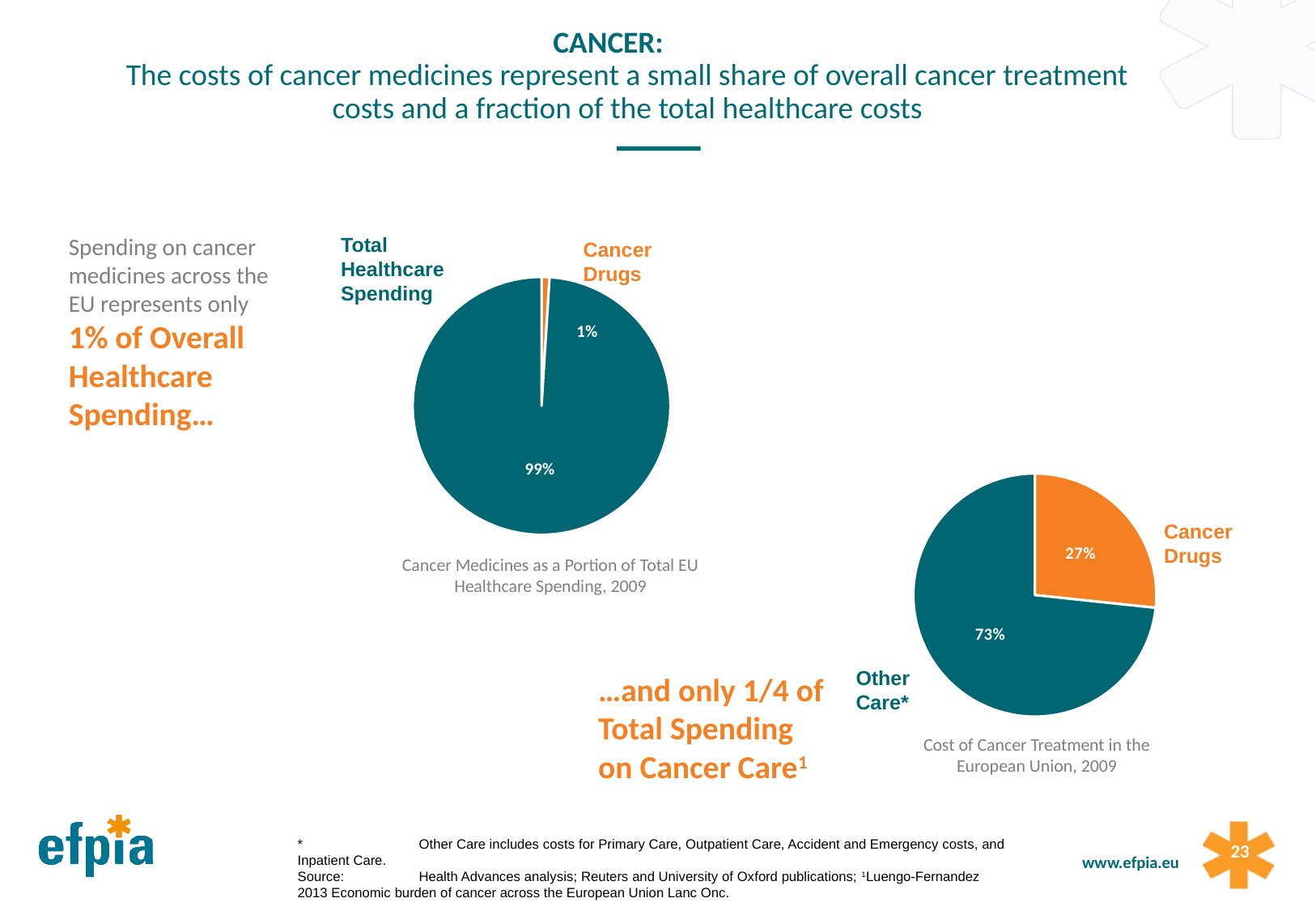
What kind of chart is the one titled 'Cost of Cancer Treatment in the European Union, 2009'? Pie chart In the chart titled 'Cancer Medicines as a Portion of Total EU Healthcare Spending, 2009', which slice is the smallest? Cancer Drugs How many slices does the chart titled 'Cancer Medicines as a Portion of Total EU Healthcare Spending, 2009' have? 2 In the chart titled 'Cost of Cancer Treatment in the European Union, 2009', which is larger, Cancer Drugs or Other Care? Other Care In the chart titled 'Cost of Cancer Treatment in the European Union, 2009', what is the difference between the Other Care share and the Cancer Drugs share? 46% In the chart titled 'Cost of Cancer Treatment in the European Union, 2009', which slice is the largest? Other Care In the chart titled 'Cost of Cancer Treatment in the European Union, 2009', what colour is the Cancer Drugs slice? Orange In the chart titled 'Cost of Cancer Treatment in the European Union, 2009', what share of the pie is Cancer Drugs? 27% In the chart titled 'Cost of Cancer Treatment in the European Union, 2009', what share of the pie is Other Care? 73% In the chart titled 'Cancer Medicines as a Portion of Total EU Healthcare Spending, 2009', what share of the pie is Cancer Drugs? 1% How many pie charts are shown on the slide? 2